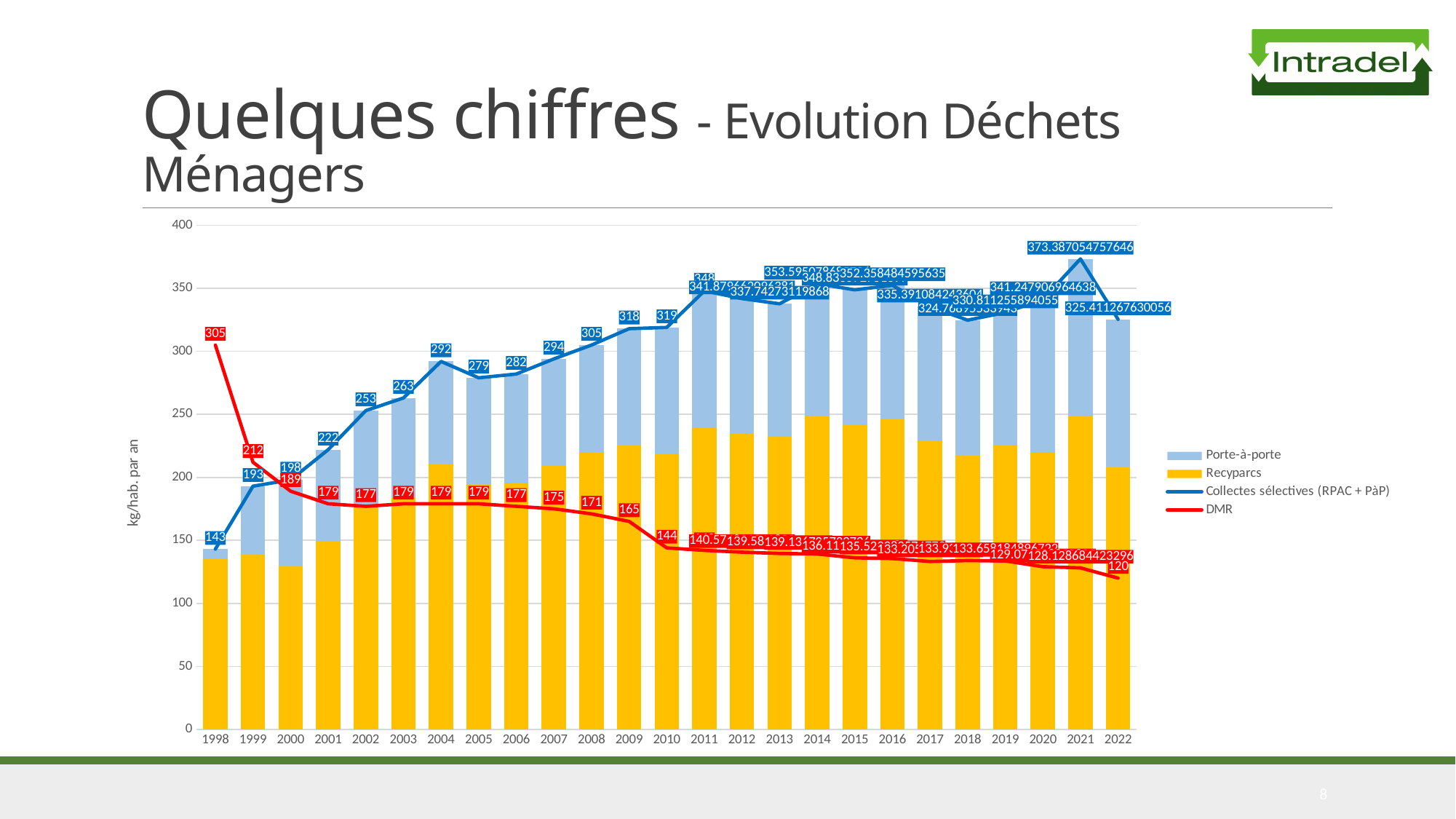
What is the difference between the DMR value in 1998 and in 2022? 185 How many series does the legend list? 4 What is the value of Collectes sélectives (RPAC + PàP) for 2021? 373.387054757646 What is the DMR value for 2022? 120 How many years are shown on the x axis? 25 Does the Collectes sélectives (RPAC + PàP) line generally rise or fall from 1998 to 2022? rise Is the Recyparcs value for 2021 greater or less than 200? greater In 2010, which is larger: Collectes sélectives (RPAC + PàP) or DMR? Collectes sélectives (RPAC + PàP) What is the DMR value for 1998? 305 In which year is the Collectes sélectives (RPAC + PàP) value lowest? 1998 What is the value of Collectes sélectives (RPAC + PàP) for 2004? 292 In which year is the DMR value highest? 1998